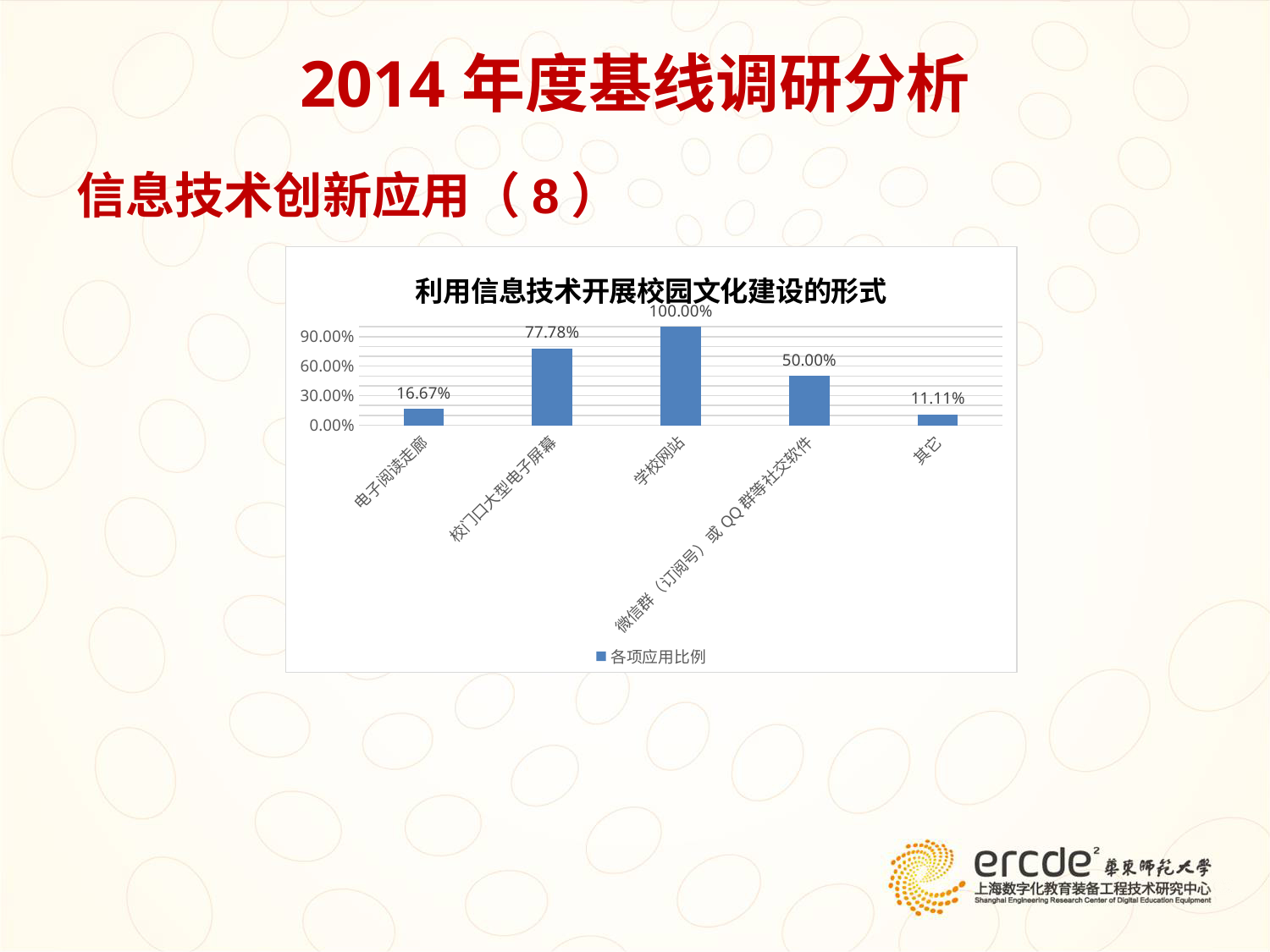
What is the value for 其它? 11.11% What is the value for 微信群（订阅号）或 QQ 群等社交软件? 50.00% Which category has the highest value? 学校网站 What is the difference between the values for 学校网站 and 微信群（订阅号）或 QQ 群等社交软件? 50.00% What is the value for 电子阅读走廊? 16.67% What is the title of the chart? 利用信息技术开展校园文化建设的形式 What is the value for 校门口大型电子屏幕? 77.78% What is the value for 学校网站? 100.00% Which category has the lowest value? 其它 How many categories are shown in the chart? 5 Which is larger, the value for 校门口大型电子屏幕 or the value for 电子阅读走廊? 校门口大型电子屏幕 What kind of chart is this? bar chart